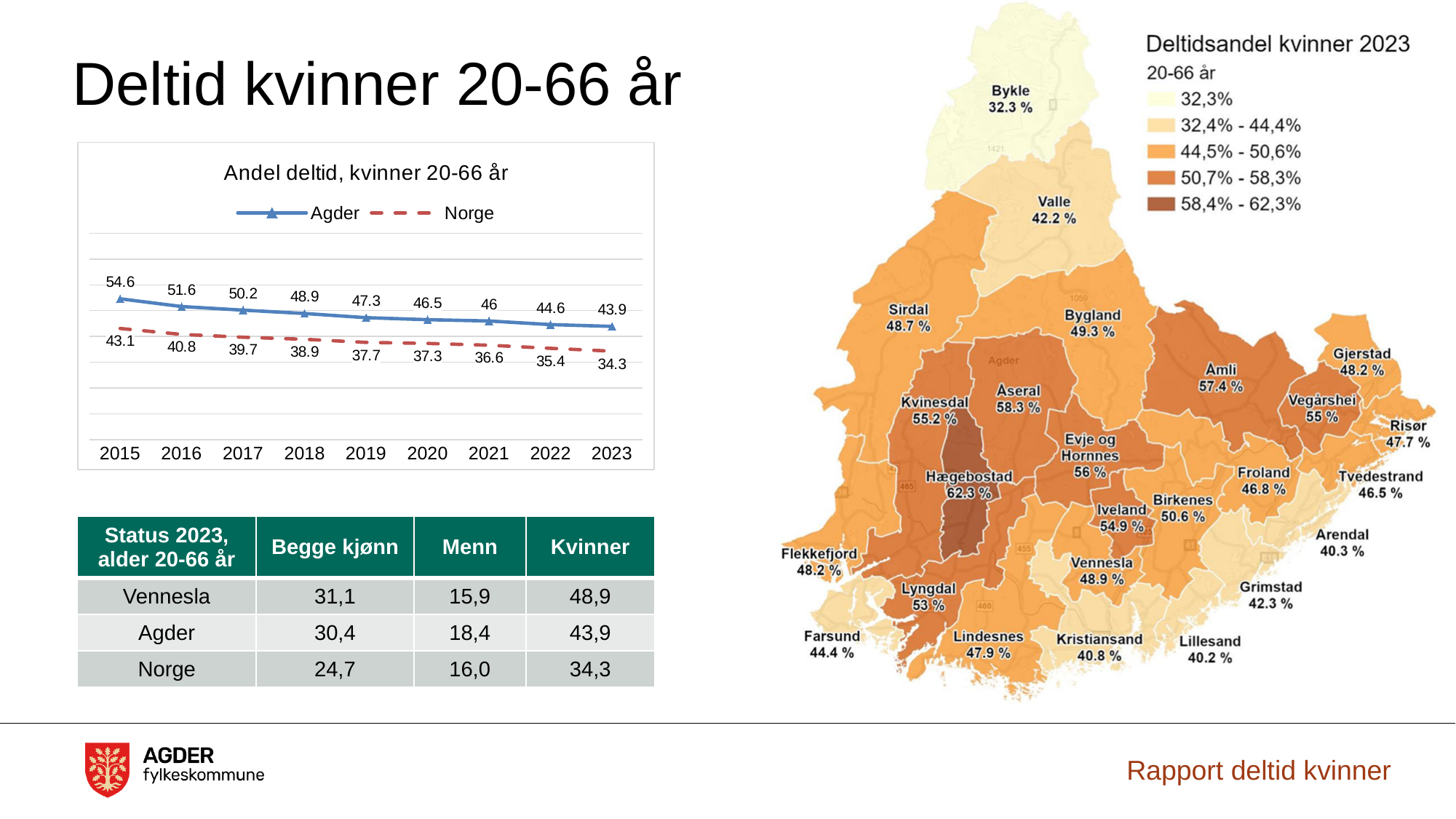
In the chart "Andel deltid, kvinner 20-66 år", what is the value for Norge in 2023? 34.3 In the chart "Andel deltid, kvinner 20-66 år", what is the difference between the Agder values in 2015 and 2023? 10.7 In the chart "Andel deltid, kvinner 20-66 år", what is the difference between Agder and Norge in 2023? 9.6 In the chart "Andel deltid, kvinner 20-66 år", which year has the lowest value for Norge? 2023 In the chart "Andel deltid, kvinner 20-66 år", what is the value for Norge in 2018? 38.9 In the chart "Andel deltid, kvinner 20-66 år", what is the value for Agder in 2021? 46 How many years are shown on the x axis of the chart "Andel deltid, kvinner 20-66 år"? 9 In the chart "Andel deltid, kvinner 20-66 år", which year has the highest value for Agder? 2015 In the chart "Andel deltid, kvinner 20-66 år", which series has the higher value in 2019, Agder or Norge? Agder What kind of chart is "Andel deltid, kvinner 20-66 år"? line chart How many series does the legend of the chart "Andel deltid, kvinner 20-66 år" list? 2 In the chart "Andel deltid, kvinner 20-66 år", what is the value for Agder in 2015? 54.6